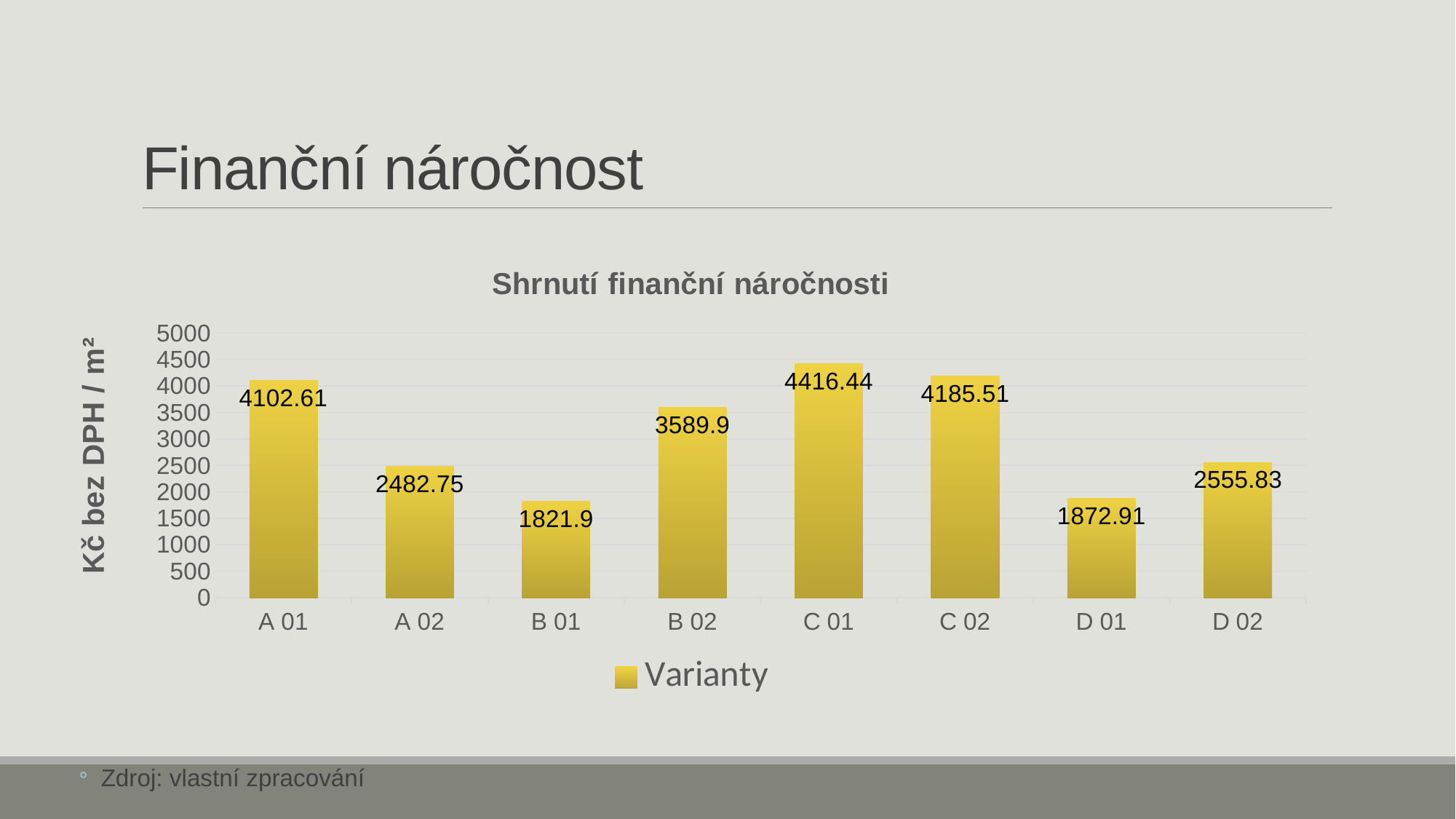
What is the value for D 02? 2555.83 Which category has the lowest value? B 01 What is the value for C 01? 4416.44 Which category has the highest value? C 01 What kind of chart is shown on the slide? bar chart What is the difference between the values for A 01 and A 02? 1619.86 What is the value for B 01? 1821.9 Which is larger, the value for B 02 or the value for D 02? B 02 What is the difference between the values for C 01 and C 02? 230.93 Is the value for D 01 greater or less than 2000? less What is the title of the chart? Shrnutí finanční náročnosti How many categories are shown on the x axis? 8